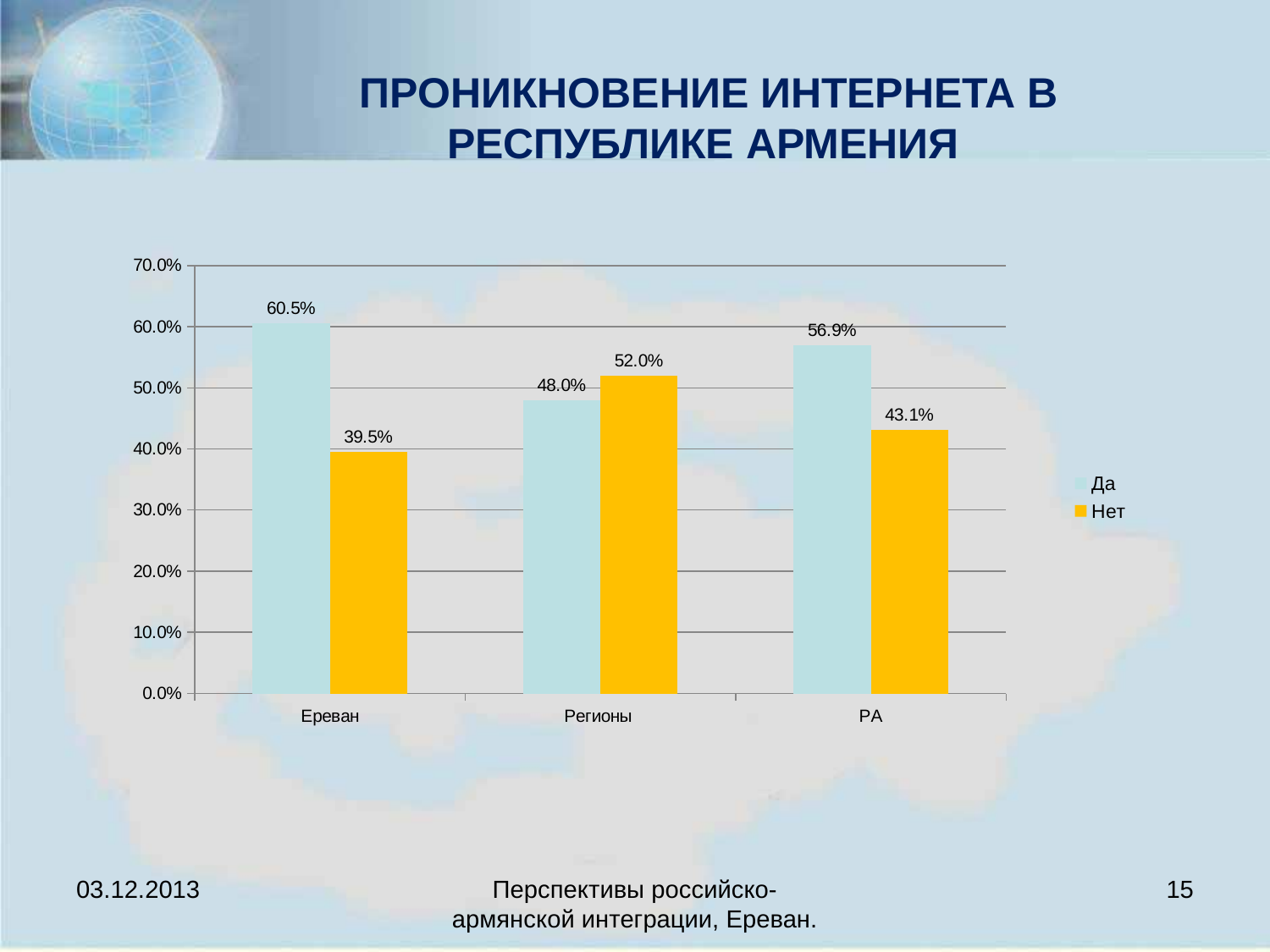
What is the value for "Нет" in Ереван? 39.5% Which is larger in Регионы, the "Да" value or the "Нет" value? Нет Which category has the highest value for "Да"? Ереван Which category has the lowest value for "Нет"? Ереван What is the difference between the "Да" and "Нет" values in Ереван? 21.0% What is the value for "Нет" in Регионы? 52.0% What kind of chart is shown on the slide? Bar chart How many series does the legend list? 2 What is the value for "Да" in РА? 56.9% Which series is shown in yellow? Нет What is the value for "Да" in Ереван? 60.5% How many categories are shown on the x axis? 3